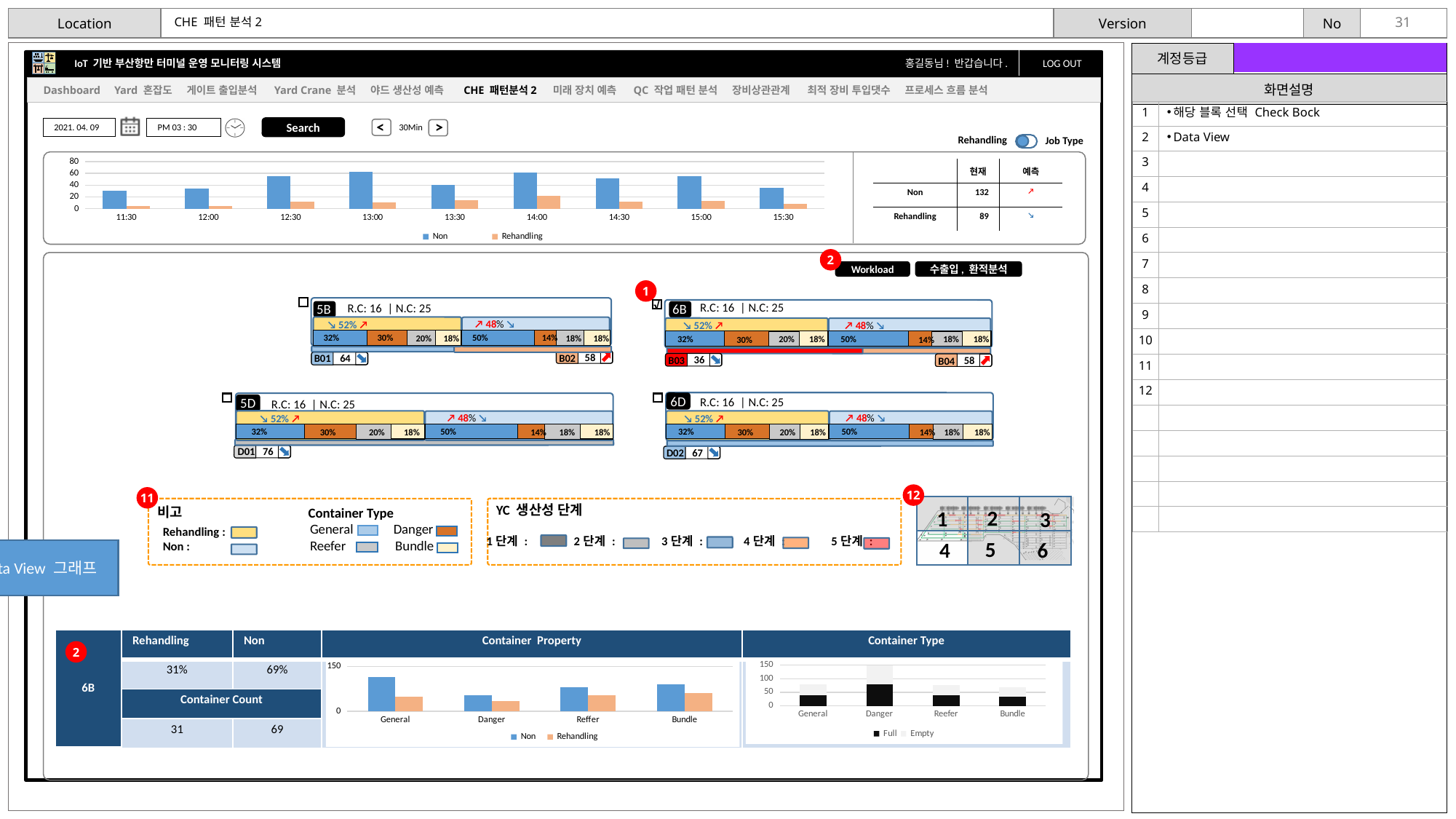
In the Container Type chart, is the total stacked value for Danger greater or less than 100? greater In the Container Property chart, which category has the lowest Non value? Danger In the top time-series chart, how many time points are shown on the x axis? 9 In the top time-series chart, at which time is the Rehandling value highest? 14:00 In the Container Property chart, which category has the highest Non value? General In the top time-series chart, at 14:00, which is larger: Non or Rehandling? Non In the top time-series chart, is the Rehandling value at 11:30 greater or less than 20? less In the top time-series chart, is the Non value at 13:00 greater or less than 40? greater In the Container Property chart, how many categories are shown on the x axis? 4 In the top time-series chart, how many series does the legend list? 2 What kind of chart is the chart at the top of the slide showing Non and Rehandling over time? bar chart In the Container Type chart, which two series does the legend list? Full and Empty